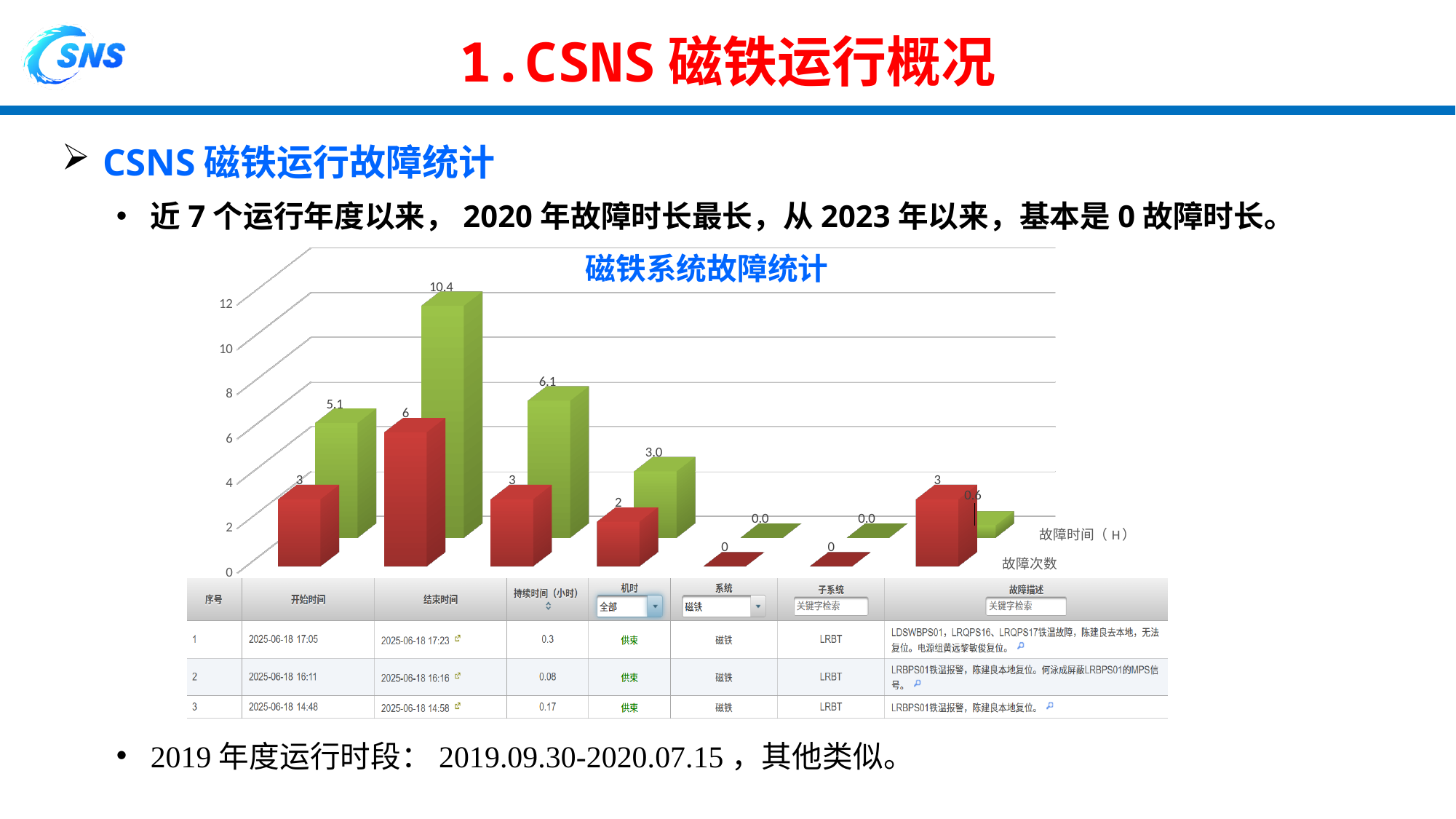
In the 磁铁系统故障统计 chart, what is the 故障次数 value for the last (rightmost) group? 3 What are the two legend entries in the 磁铁系统故障统计 chart? 故障时间（H） and 故障次数 In the 磁铁系统故障统计 chart, is the tallest 故障时间（H） bar greater or less than 10? greater How many category groups of bars are plotted in the 磁铁系统故障统计 chart? 7 What is the highest 故障时间（H） value shown in the 磁铁系统故障统计 chart? 10.4 How many series does the legend of the 磁铁系统故障统计 chart list? 2 What is the highest 故障次数 value shown in the 磁铁系统故障统计 chart? 6 What kind of chart is the 磁铁系统故障统计 chart? bar chart In the 磁铁系统故障统计 chart, what is the difference between the two largest 故障时间（H） values, 10.4 and 6.1? 4.3 In the 磁铁系统故障统计 chart, what is the 故障时间（H） value for the group whose 故障次数 is 6? 10.4 In the 磁铁系统故障统计 chart, how many groups have a 故障次数 of 0? 2 In the 磁铁系统故障统计 chart, what is the 故障时间（H） value for the last (rightmost) group? 0.6